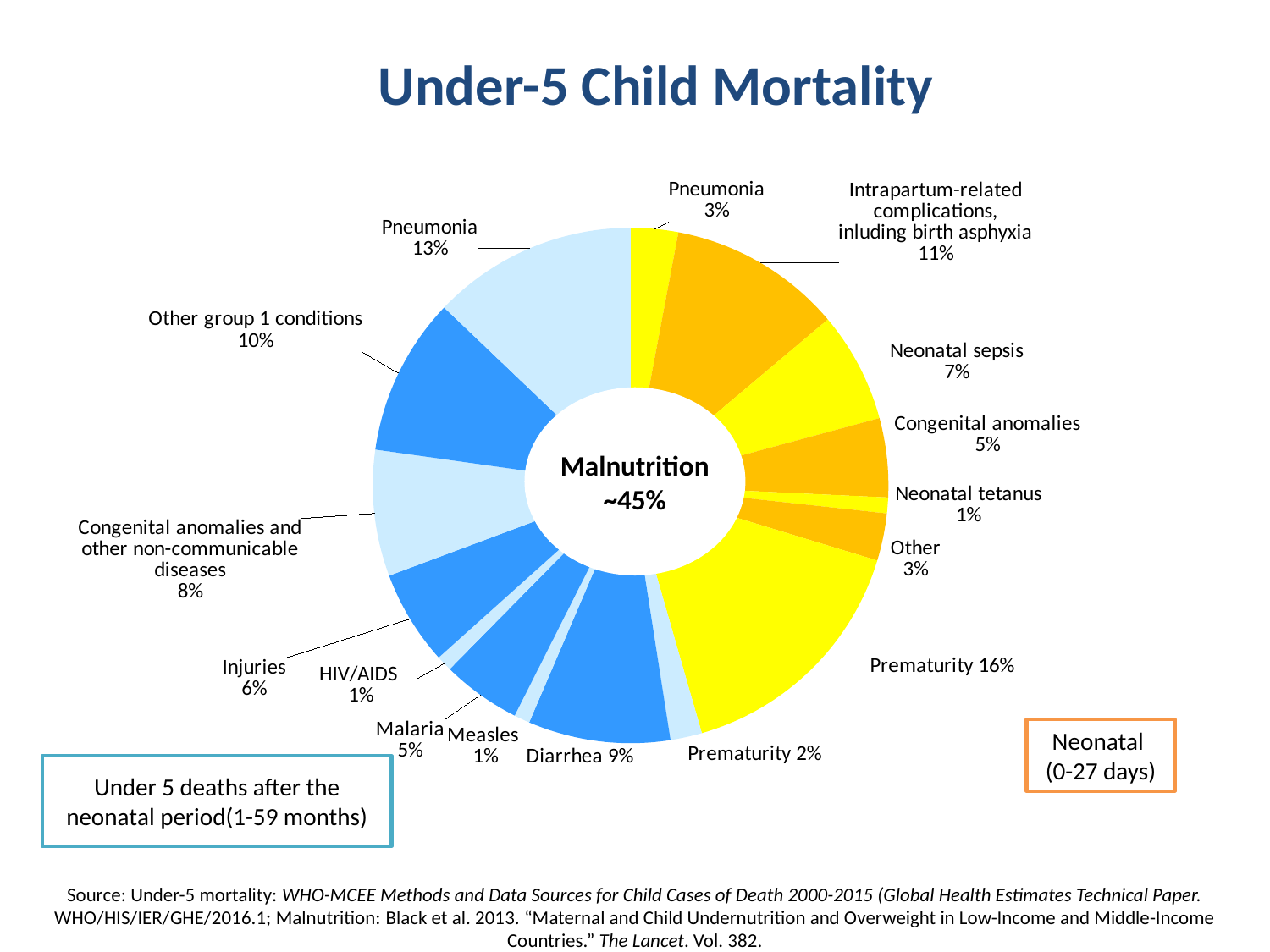
What percentage is shown for Diarrhea? 9% Which is larger, the share for Other group 1 conditions or the share for Congenital anomalies and other non-communicable diseases? Other group 1 conditions What percentage is shown for Intrapartum-related complications, including birth asphyxia? 11% What is the difference between the Pneumonia share after the neonatal period (13%) and the Pneumonia share in the neonatal period (3%)? 10 percentage points Which is larger, the share for Injuries or the share for Malaria? Injuries What text is shown in the centre of the pie chart? Malnutrition ~45% What type of chart is shown on the slide? Pie chart What percentage is shown for Neonatal sepsis? 7% Which slice of the pie chart is the largest? Prematurity 16% How many slices does the pie chart have? 16 What percentage of under-5 child mortality is attributed to Prematurity in the neonatal period (the 16% slice)? 16% What percentage is shown for Pneumonia in the under-5 deaths after the neonatal period (1-59 months) group? 13%